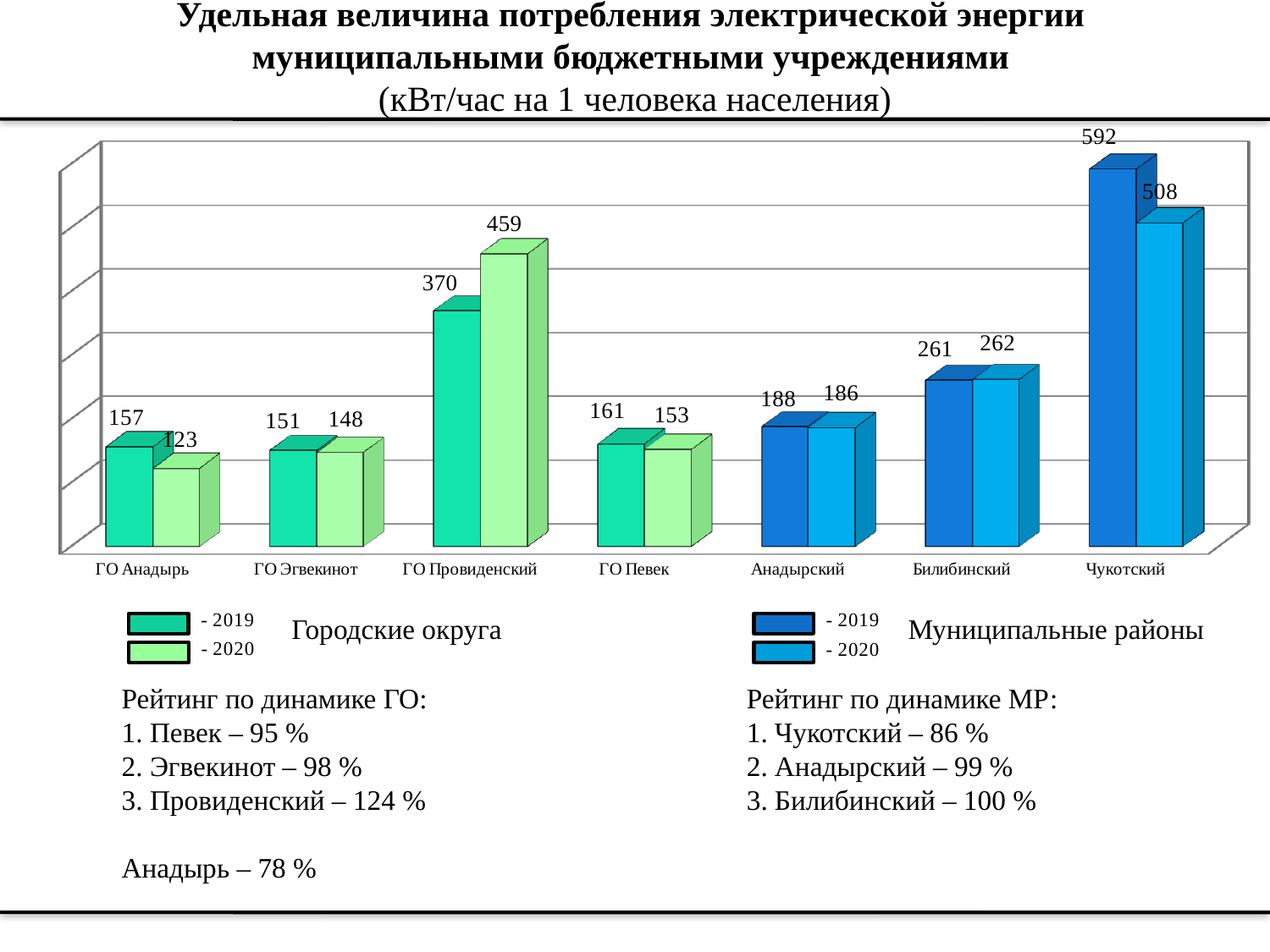
How many categories are shown on the x axis of the chart? 7 Which two years does the legend list for the Городские округа group? 2019 and 2020 Which category has the highest 2019 value? Чукотский What is the 2019 value for ГО Певек? 161 What kind of chart is shown on the slide? Bar chart What is the 2020 value for Чукотский? 508 What is the difference between the 2020 and 2019 values for ГО Провиденский? 89 Which is larger: the 2019 value for Билибинский or the 2019 value for Анадырский? Билибинский What is the 2020 value for ГО Анадырь? 123 What is the 2019 value for ГО Провиденский? 370 Which category has the lowest 2020 value? ГО Анадырь What is the difference between the 2019 and 2020 values for Чукотский? 84